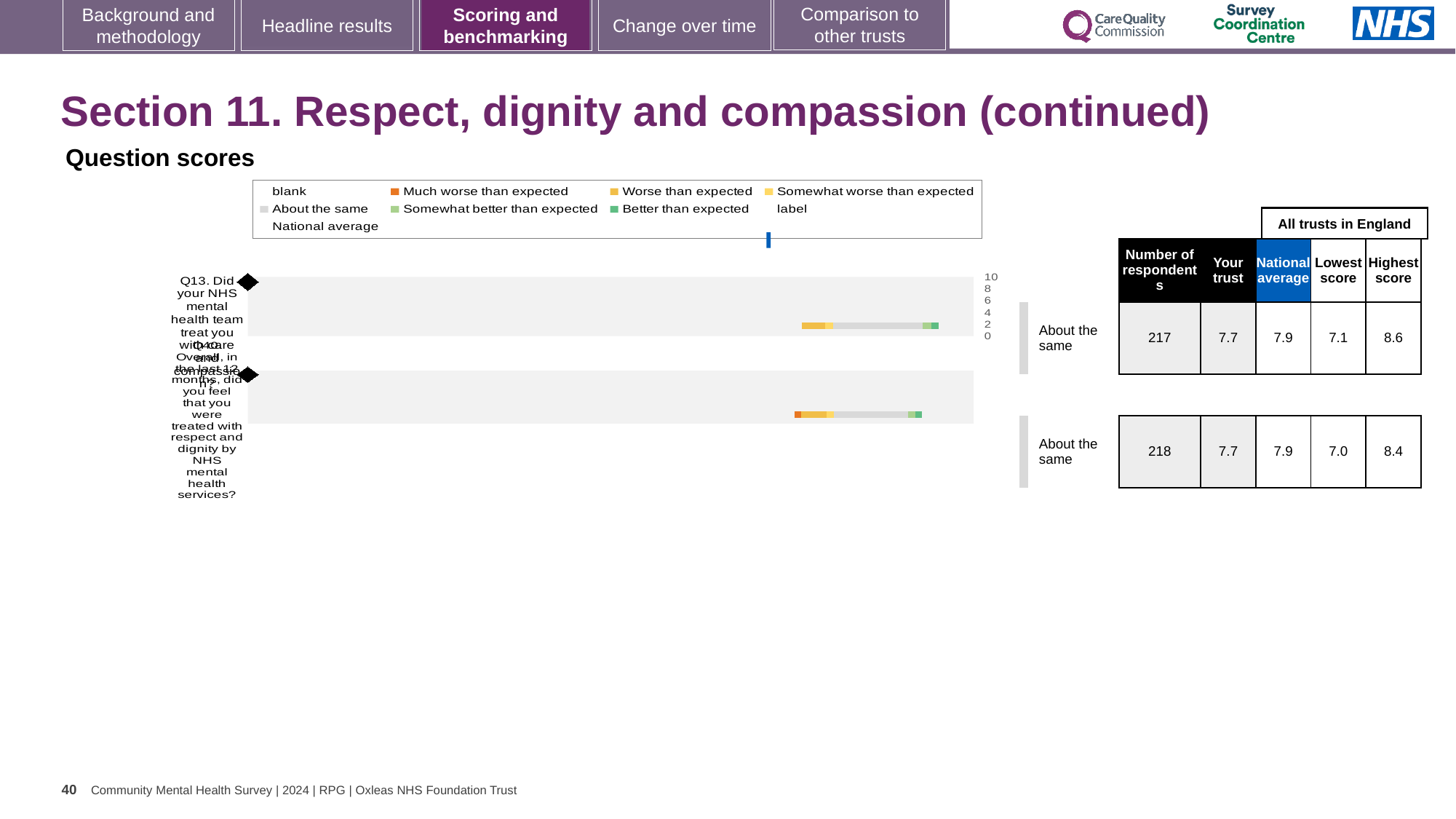
What is the lowest score among all trusts in England for Q40? 7.0 How many respondents are shown for Q13 in the table next to the chart? 217 How many respondents are shown for Q40? 218 What is the highest score among all trusts in England for Q13? 8.6 How many survey questions are plotted in the chart? 2 What benchmark category is shown for Q13 next to the chart? About the same What is the 'Your trust' score for Q13? 7.7 What is the highest score among all trusts in England for Q40? 8.4 Which question has the higher 'Highest score' value, Q13 or Q40? Q13 What is the lowest score among all trusts in England for Q13? 7.1 What is the difference between the highest score and the lowest score for Q13? 1.5 What is the national average score for Q13? 7.9